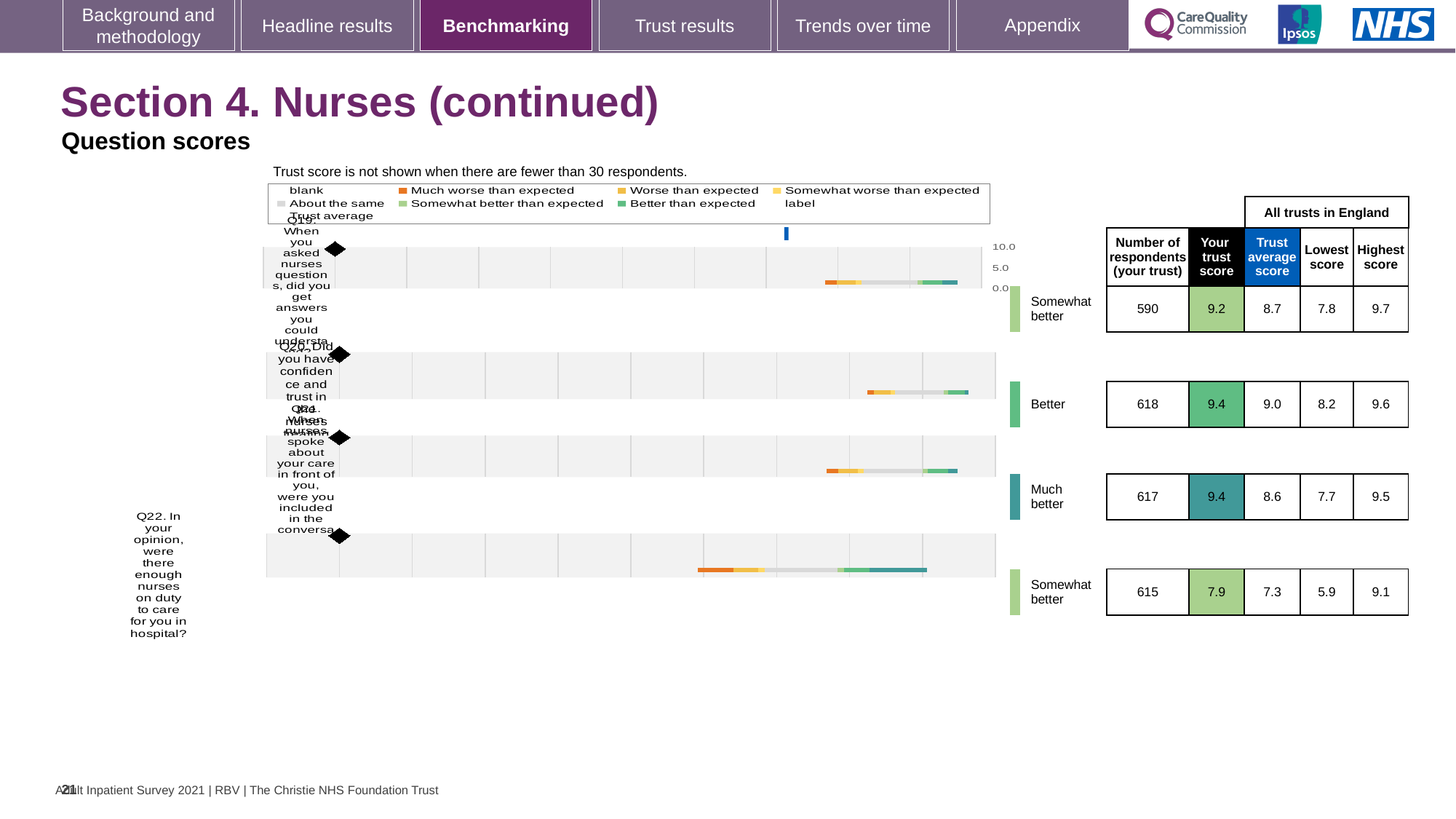
Which question has the lowest 'Your trust score'? Q22 What is the highest score across all trusts in England for Q19? 9.7 What is the maximum value shown on the chart's score axis? 10.0 How many questions (categories) are plotted in the chart? 4 What is the lowest score across all trusts in England for Q22? 5.9 What is the 'Your trust score' value for Q22 (were there enough nurses on duty)? 7.9 What is the difference between the trust score and the trust average score for Q22? 0.6 How many respondents from your trust answered Q20 (confidence and trust in the nurses)? 618 What benchmark category label is shown next to Q21? Much better What kind of chart is used to show the question scores on this slide? bar chart For Q19, which is larger: the 'Your trust score' or the 'Trust average score'? Your trust score What is the trust average score for Q21 (were you included in the conversation)? 8.6